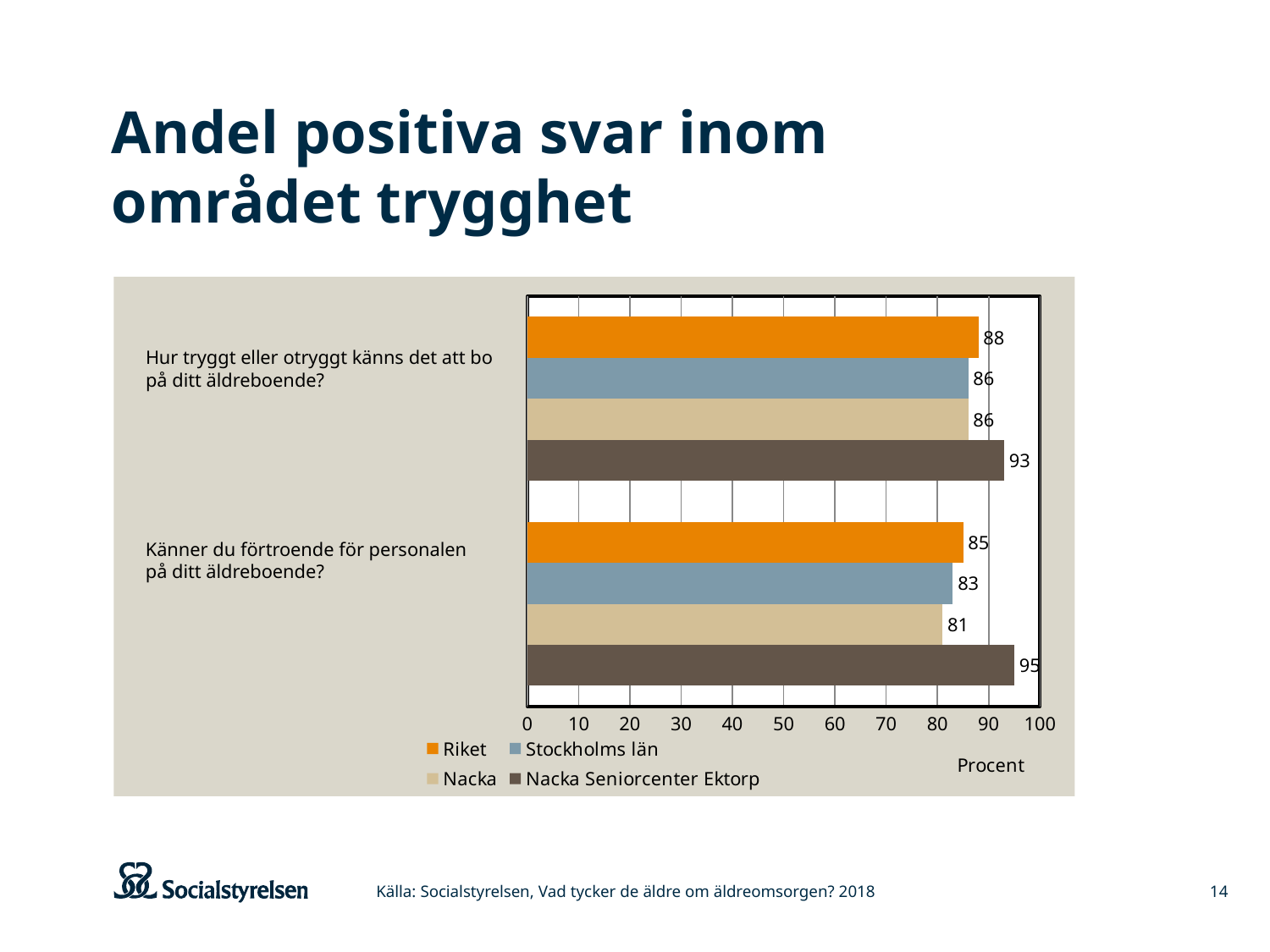
Which is larger on the question "Hur tryggt eller otryggt känns det att bo på ditt äldreboende?": Riket or Nacka Seniorcenter Ektorp? Nacka Seniorcenter Ektorp What is the value for Nacka Seniorcenter Ektorp on the question "Känner du förtroende för personalen på ditt äldreboende?"? 95 What is the label of the horizontal axis? Procent Which series has the highest value on the question "Känner du förtroende för personalen på ditt äldreboende?"? Nacka Seniorcenter Ektorp What is the value for Stockholms län on the question "Hur tryggt eller otryggt känns det att bo på ditt äldreboende?"? 86 What kind of chart is shown on the slide? Bar chart What is the value for Riket on the question "Hur tryggt eller otryggt känns det att bo på ditt äldreboende?"? 88 How many questions (categories) are shown on the chart? 2 What is the difference between Nacka Seniorcenter Ektorp and Nacka on the question "Känner du förtroende för personalen på ditt äldreboende?"? 14 How many series does the legend list? 4 What is the value for Nacka on the question "Känner du förtroende för personalen på ditt äldreboende?"? 81 Which series has the lowest value on the question "Känner du förtroende för personalen på ditt äldreboende?"? Nacka